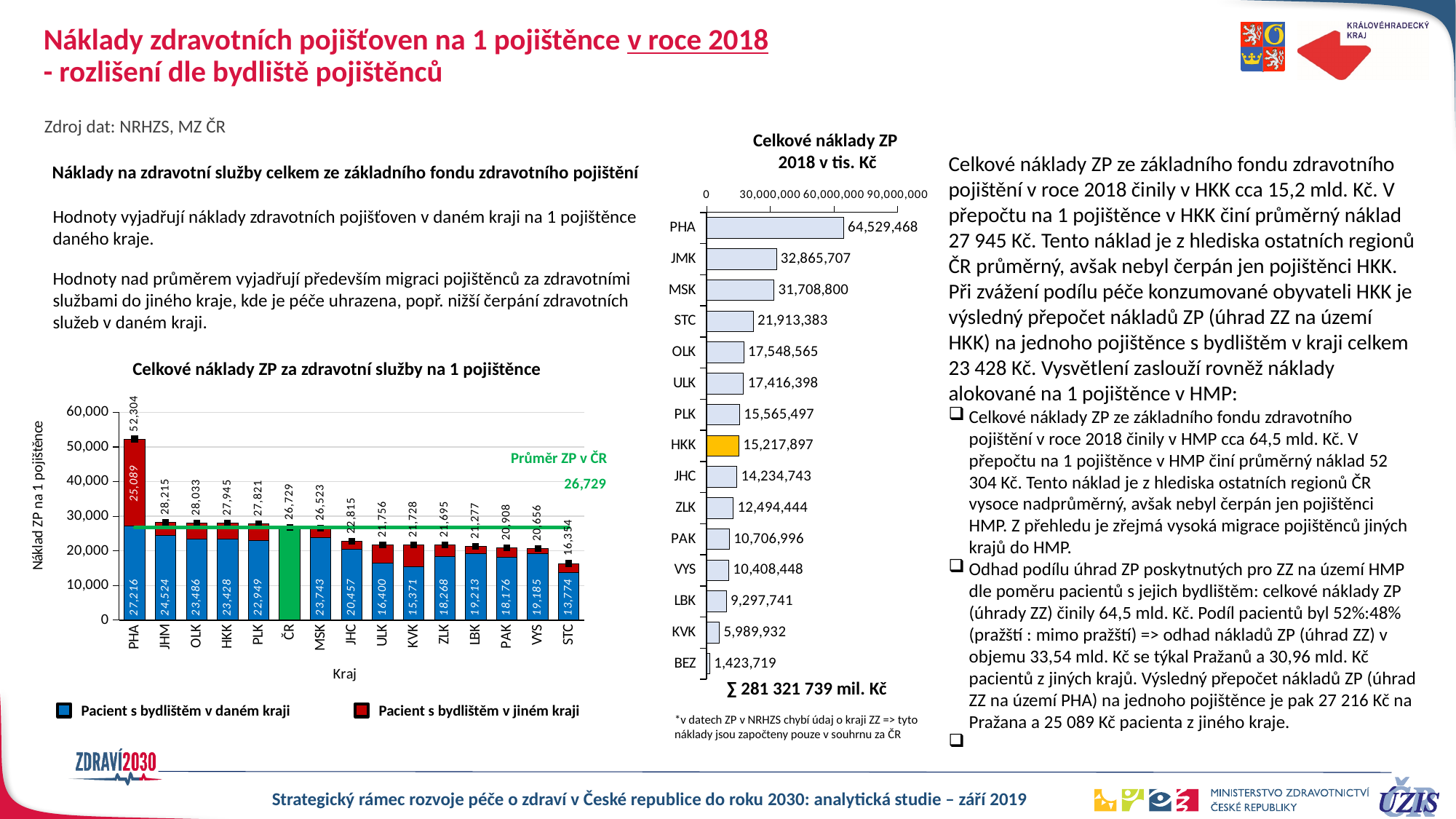
In the chart 'Celkové náklady ZP 2018 v tis. Kč', which is larger, the value for OLK or the value for ULK? OLK In the chart 'Celkové náklady ZP za zdravotní služby na 1 pojištěnce', what is the value of 'Pacient s bydlištěm v jiném kraji' for PHA? 25,089 In the chart 'Celkové náklady ZP 2018 v tis. Kč', which category has the lowest value? BEZ In the chart 'Celkové náklady ZP 2018 v tis. Kč', how many bars are shown? 15 In the chart 'Celkové náklady ZP za zdravotní služby na 1 pojištěnce', how many series does the legend list? 2 In the chart 'Celkové náklady ZP 2018 v tis. Kč', what is the difference between the values for JMK and MSK? 1,156,907 In the chart 'Celkové náklady ZP 2018 v tis. Kč', which region has the highest value? PHA What kind of chart is 'Celkové náklady ZP 2018 v tis. Kč'? Bar chart In the chart 'Celkové náklady ZP za zdravotní služby na 1 pojištěnce', what is the total value for PHA? 52,304 In the chart 'Celkové náklady ZP 2018 v tis. Kč', what is the value for HKK? 15,217,897 In the chart 'Celkové náklady ZP za zdravotní služby na 1 pojištěnce', which region has the lowest total value? STC In the chart 'Celkové náklady ZP za zdravotní služby na 1 pojištěnce', what is the value of 'Pacient s bydlištěm v daném kraji' for HKK? 23,428